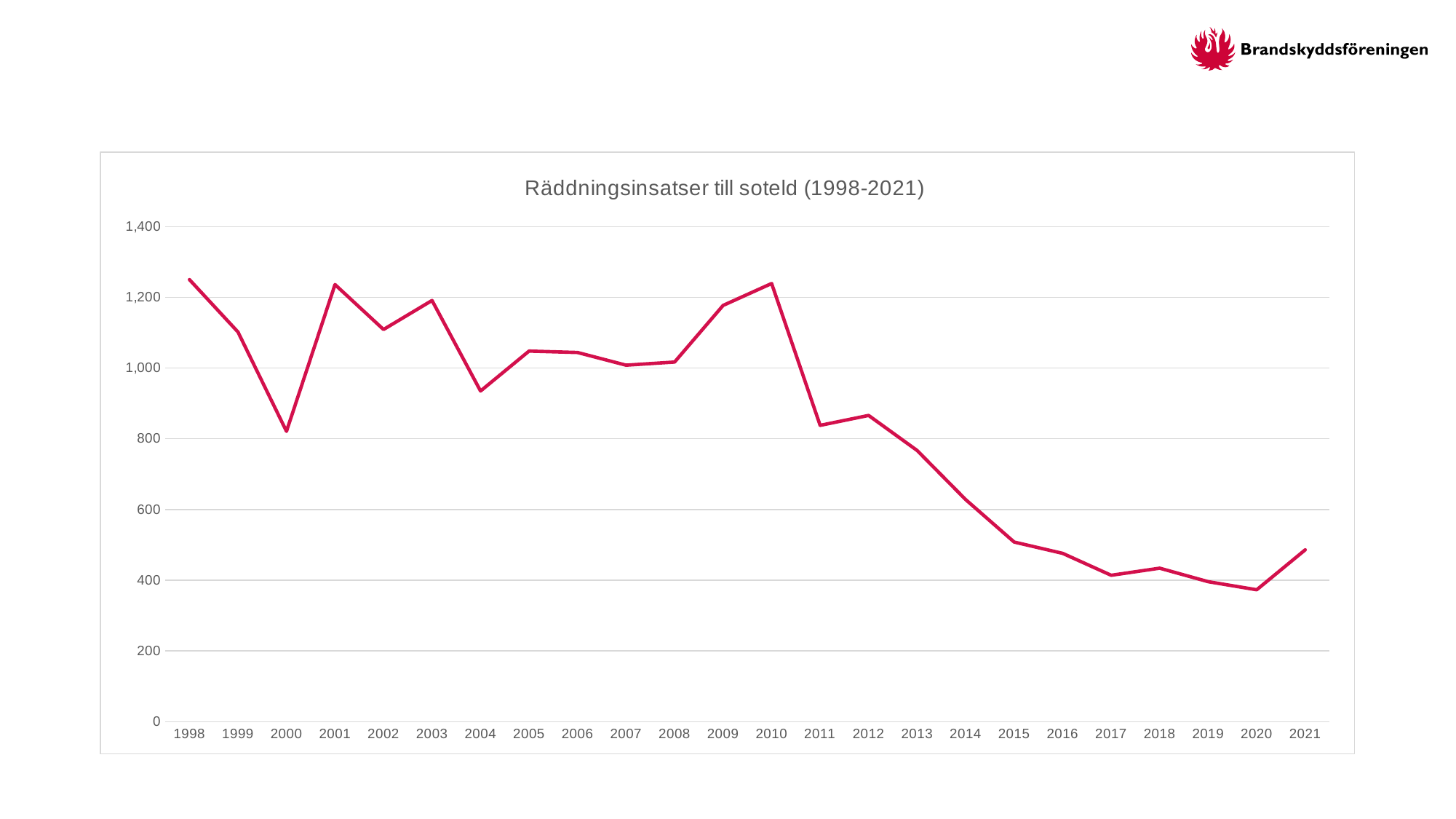
What kind of chart is shown on the slide? line chart Is the value for 2000 greater or less than 1,000? less Is the value for 2010 greater or less than 1,000? greater Is the value for 2014 greater or less than 800? less Which year has the larger value, 2000 or 2001? 2001 Overall, do the values rise or fall from 1998 to 2021? fall What is the title of the chart? Räddningsinsatser till soteld (1998-2021) How many years are plotted along the x axis? 24 Which year has the larger value, 2015 or 2021? 2015 Which year has the larger value, 2010 or 2011? 2010